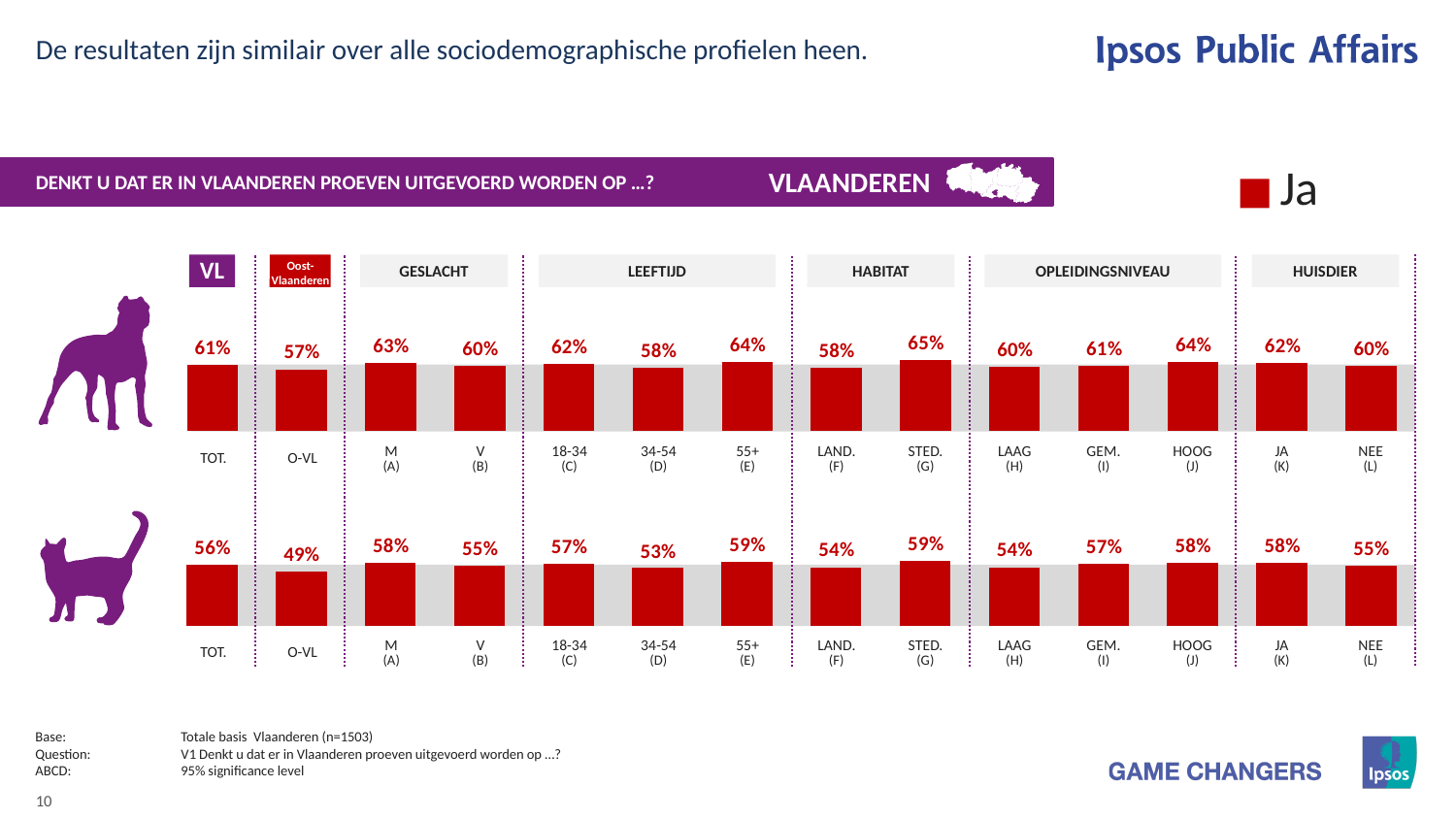
In the top chart (dog row), what is the difference between M (A) and V (B)? 3% In the bottom chart (cat row), what is the difference between TOT. and O-VL? 7% In the bottom chart (cat row), what is the value for 34-54 (D) under LEEFTIJD? 53% How many bars are shown in the top chart (dog row)? 14 In the bottom chart (cat row), what is the value for O-VL? 49% What type of chart is used on this slide? Bar chart In the top chart (dog row), which category has the highest value? STED. (G) In the bottom chart (cat row), which is larger: JA (K) or NEE (L)? JA (K) In the bottom chart (cat row), which category has the lowest value? O-VL In the top chart (dog row), what is the value for TOT.? 61% In the top chart (dog row), what is the value for STED. (G) under HABITAT? 65% In the top chart (dog row), which is larger: LAAG (H) or HOOG (J)? HOOG (J)